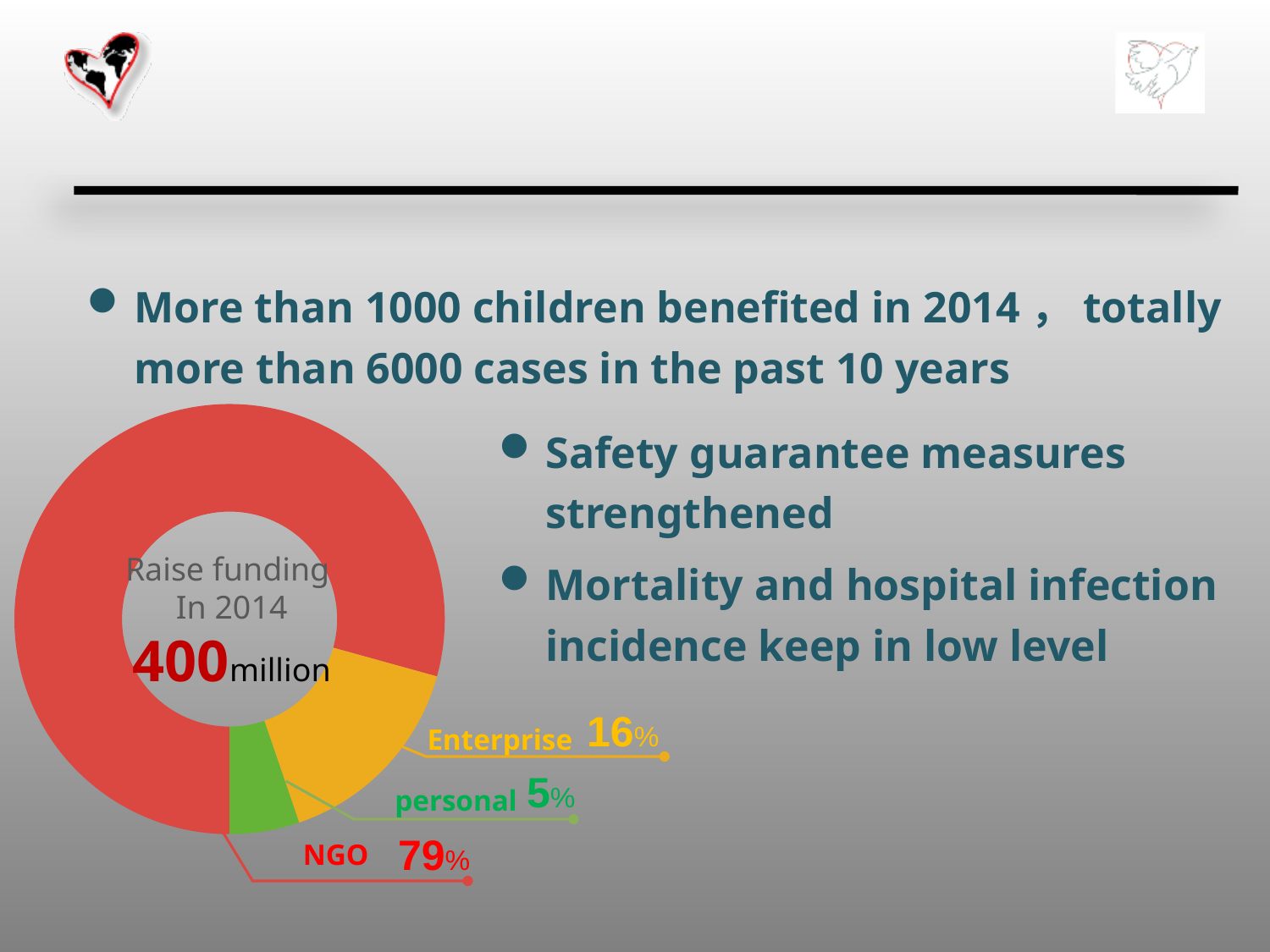
What total amount of funding raised in 2014 is shown in the centre of the chart? 400 million What share of the funding raised in 2014 came from personal sources? 5% What kind of chart is shown on the slide? Donut (pie) chart What share of the funding raised in 2014 came from NGO? 79% What is the difference in percentage points between the NGO share and the Enterprise share? 63 Which funding source has the smallest share in the chart? personal How many funding sources (slices) does the chart show? 3 Which funding source has the largest share in the chart? NGO What share of the funding raised in 2014 came from Enterprise? 16% Which is larger, the Enterprise share or the personal share? Enterprise What is the difference in percentage points between the Enterprise share and the personal share? 11 What colour is the NGO slice of the chart? Red